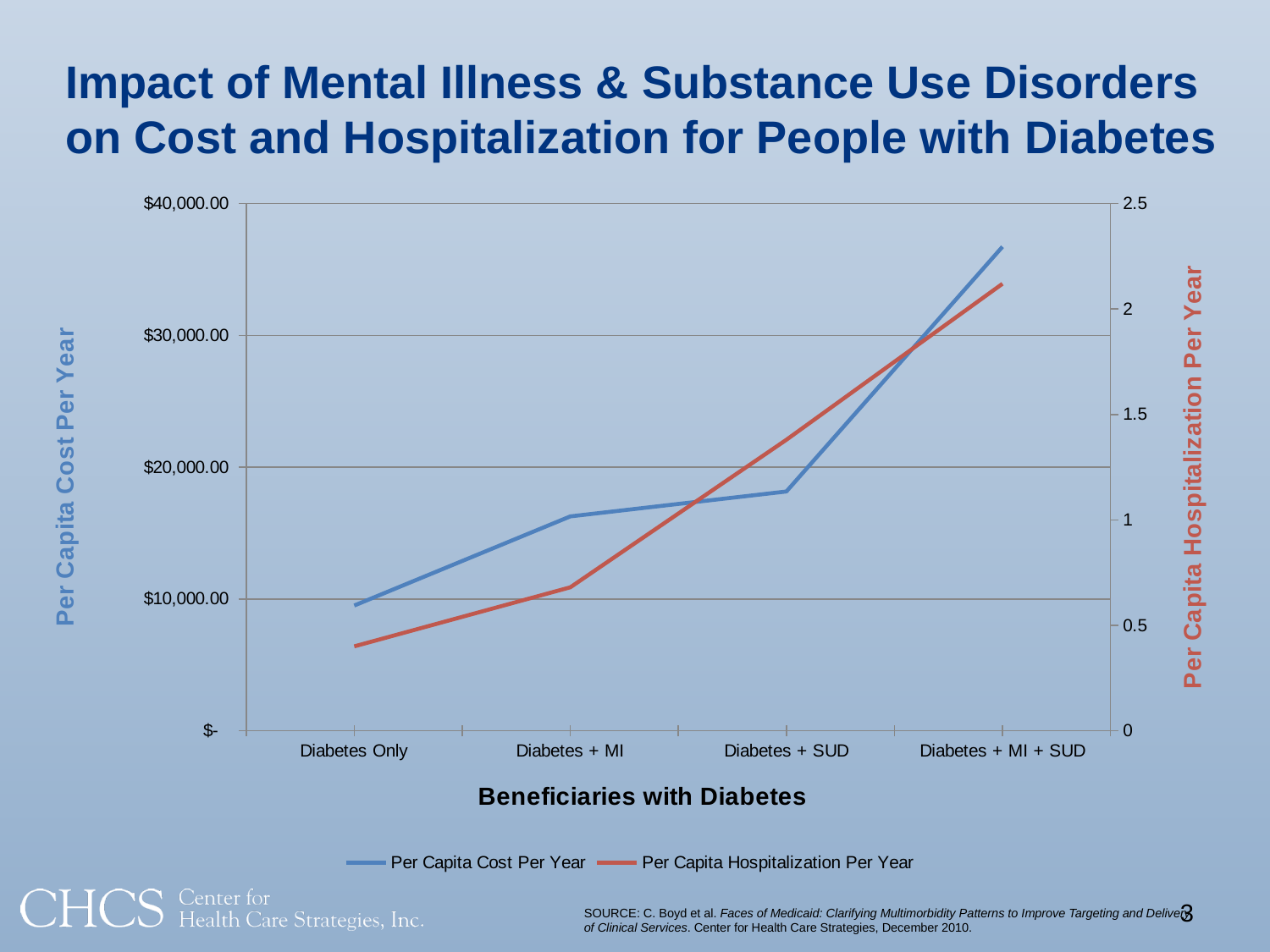
Which category has the lowest Per Capita Hospitalization Per Year? Diabetes Only Which has the higher Per Capita Cost Per Year, Diabetes + MI or Diabetes + SUD? Diabetes + SUD How many categories are shown on the x axis? 4 Which category has the highest Per Capita Cost Per Year? Diabetes + MI + SUD Is the Per Capita Cost Per Year for Diabetes + SUD greater or less than $20,000.00? less Is the Per Capita Hospitalization Per Year for Diabetes + MI + SUD greater or less than 2? greater What kind of chart is shown on the slide? line chart Do the Per Capita Hospitalization Per Year values rise or fall from Diabetes Only to Diabetes + MI + SUD? rise How many series does the legend list? 2 Is the Per Capita Cost Per Year for Diabetes + MI + SUD greater or less than $30,000.00? greater What is the title of the x axis? Beneficiaries with Diabetes